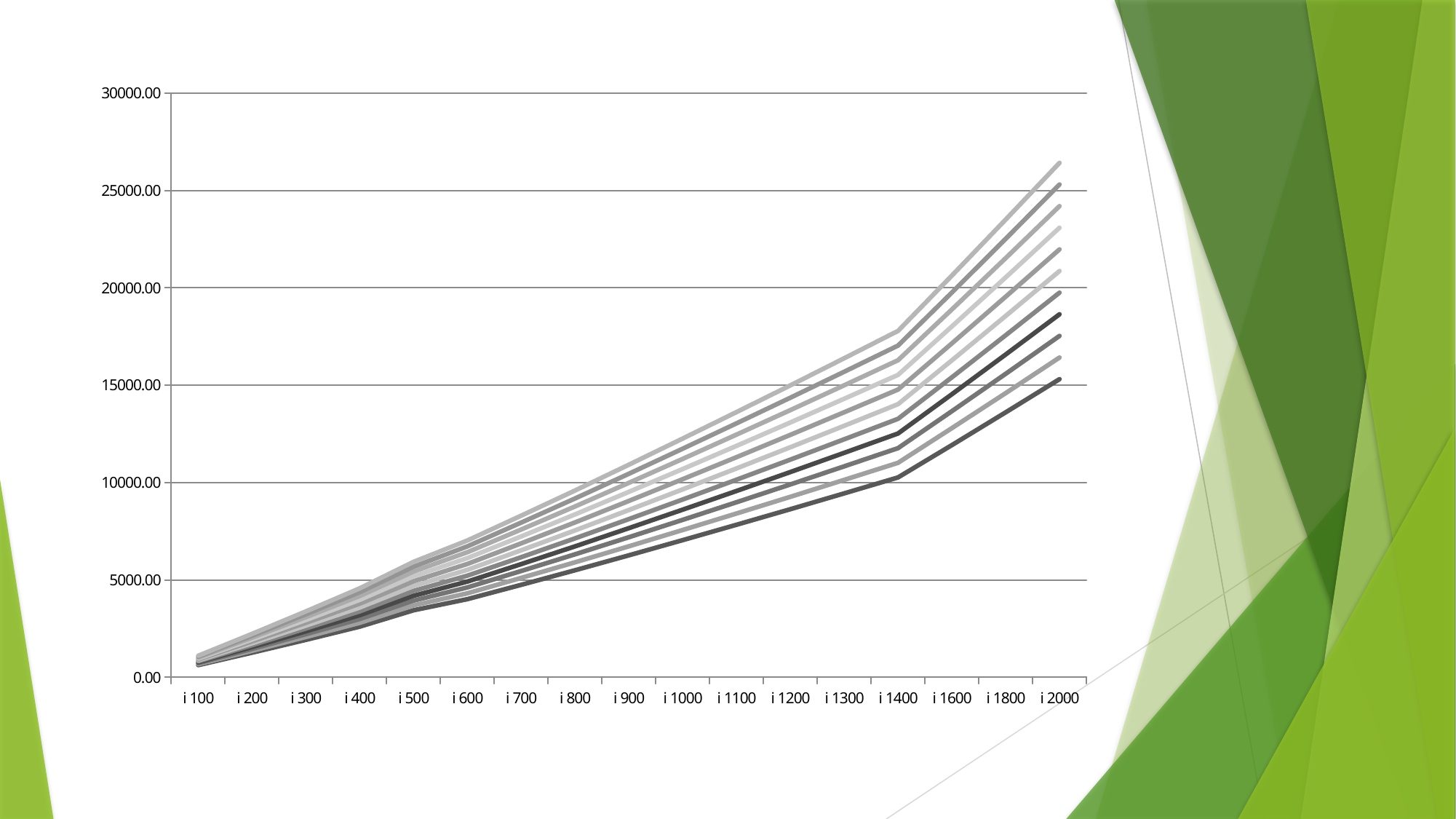
How many categories are shown on the x axis? 17 Is the value of the lowest line at i 500 greater or less than 5000? less Is the value of the lowest line at i 1400 greater or less than 15000? less Do the plotted values generally rise or fall from i 100 to i 2000? rise Is the value of the lowest line at i 2000 greater or less than 20000? less What is the label of the first category on the x axis? i 100 What is the highest tick value shown on the y axis? 30000.00 What kind of chart is shown on the slide? line chart